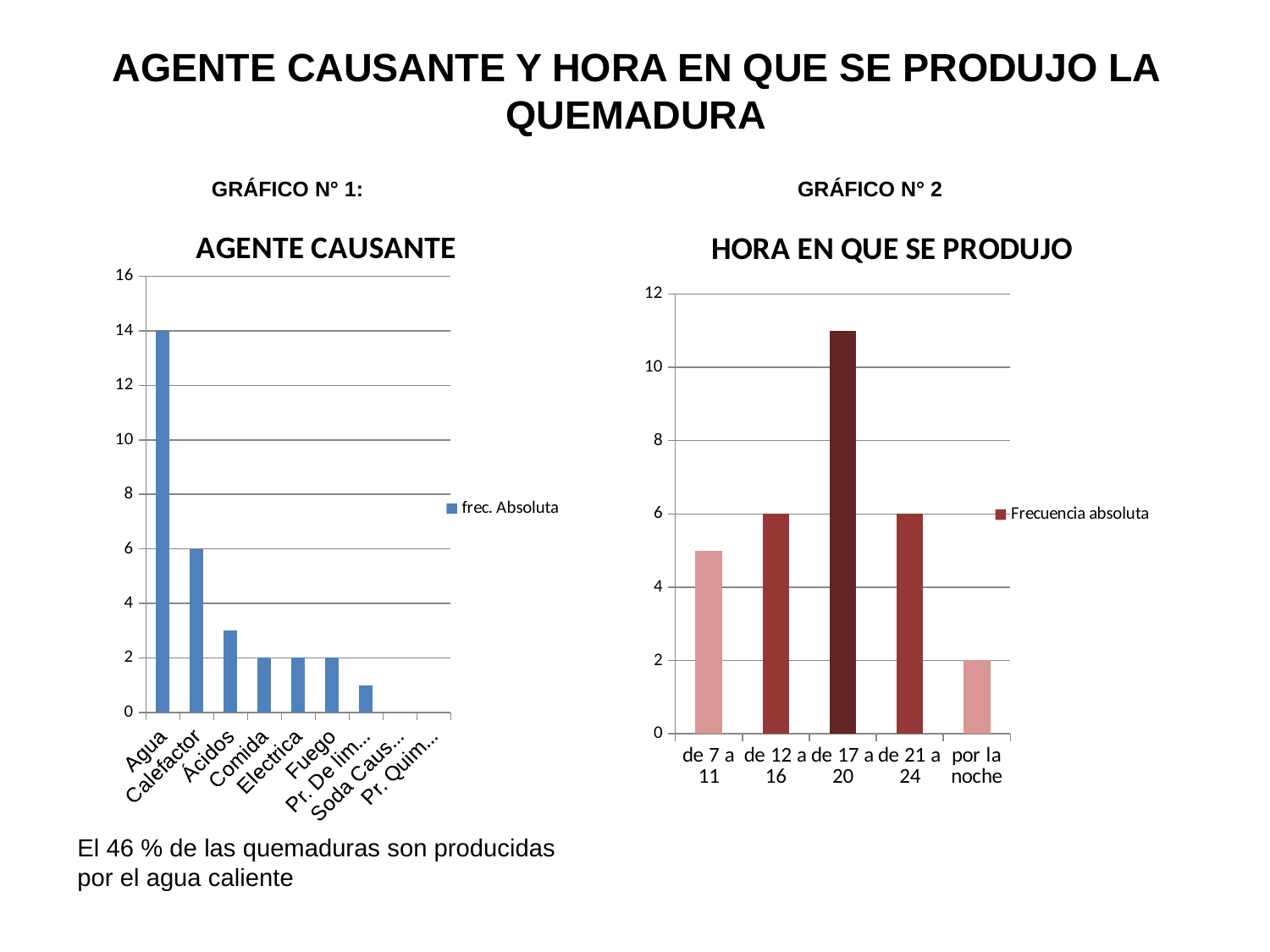
In the AGENTE CAUSANTE chart, which category has the highest value? Agua In the AGENTE CAUSANTE chart, what is the value for Calefactor? 6 What is the legend entry of the HORA EN QUE SE PRODUJO chart? Frecuencia absoluta In the HORA EN QUE SE PRODUJO chart, what is the value for de 12 a 16? 6 In the AGENTE CAUSANTE chart, what is the value for Agua? 14 In the AGENTE CAUSANTE chart, is the value for Ácidos greater or less than 4? less In the HORA EN QUE SE PRODUJO chart, which is larger, the value for de 17 a 20 or the value for de 7 a 11? de 17 a 20 In the AGENTE CAUSANTE chart, what is the difference between the values for Agua and Calefactor? 8 In the HORA EN QUE SE PRODUJO chart, which category has the lowest value? por la noche What kind of chart is the HORA EN QUE SE PRODUJO chart? bar chart In the HORA EN QUE SE PRODUJO chart, is the value for de 17 a 20 greater or less than 10? greater How many categories are shown on the x axis of the AGENTE CAUSANTE chart? 9